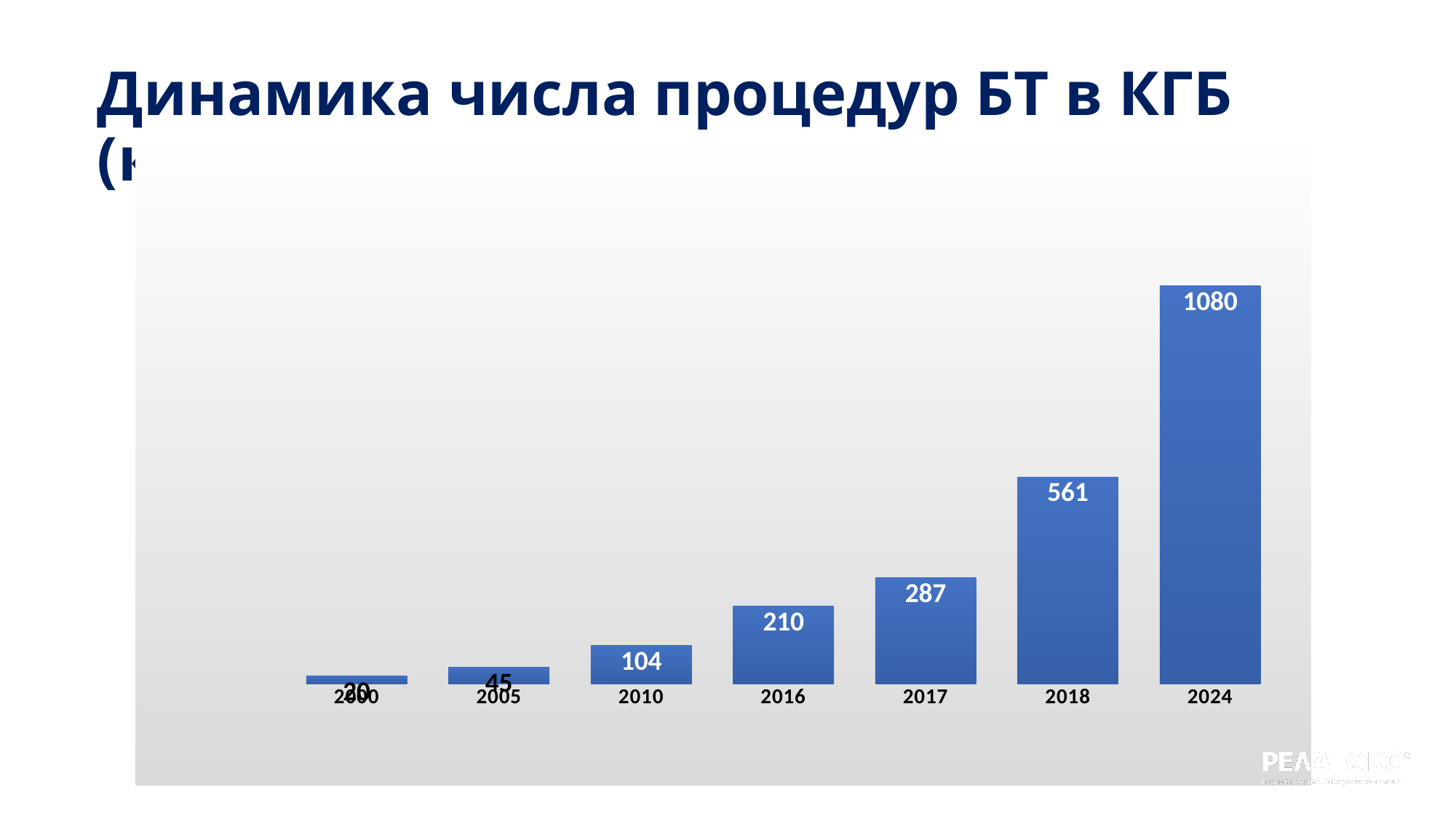
How many years are shown on the x axis? 7 Do the values rise or fall from 2000 to 2024? rise What is the value for 2018? 561 What is the value for 2024? 1080 What is the value for 2017? 287 What is the difference between the values for 2024 and 2018? 519 What is the value for 2010? 104 Which year has the highest value? 2024 What is the value for 2005? 45 Which is larger, the value for 2016 or the value for 2010? 2016 Which year has the lowest value? 2000 What is the value for 2016? 210